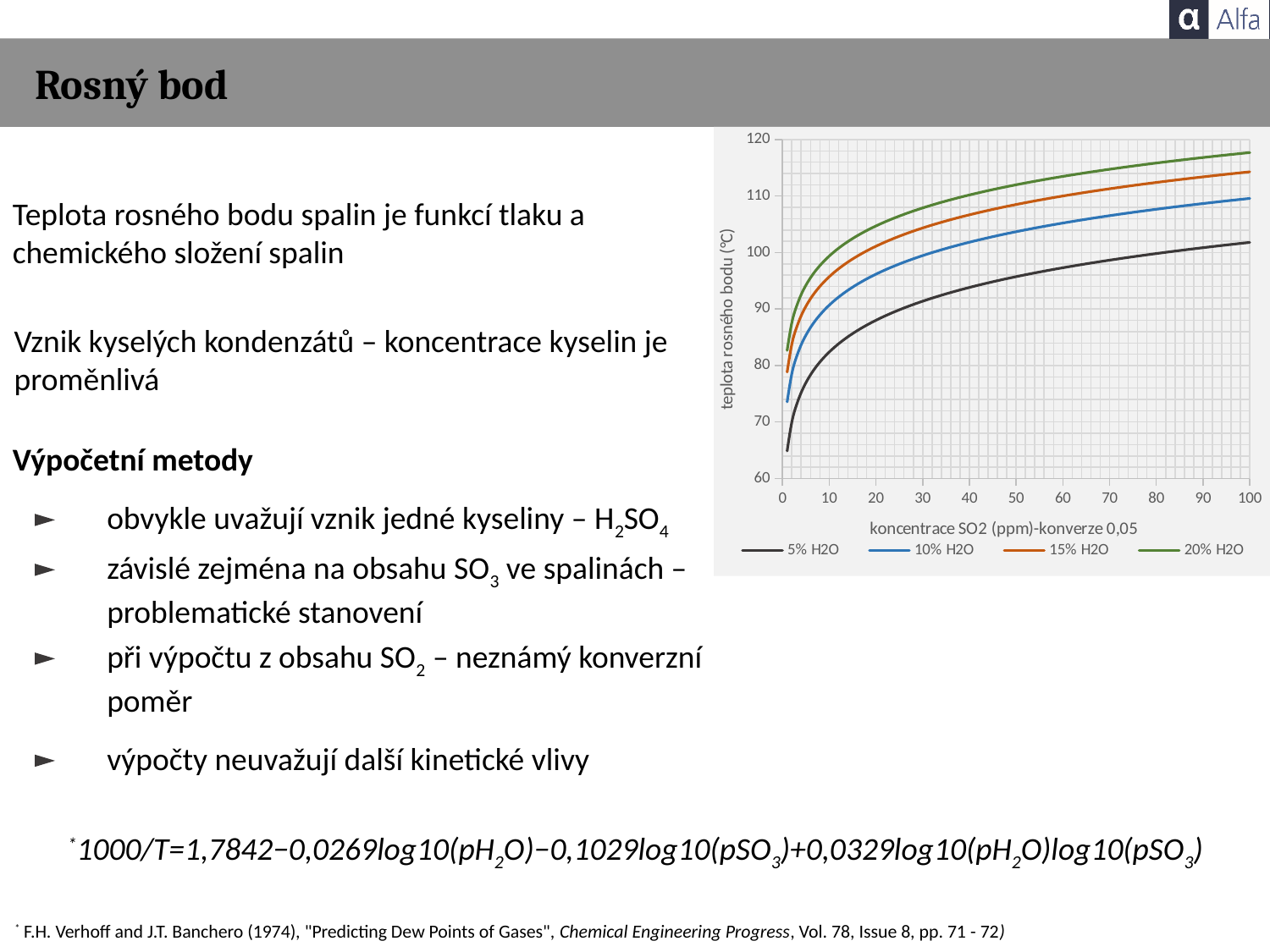
Is the dew point temperature for 5% H2O at 10 ppm SO2 greater or less than 80? greater Is the dew point temperature for 20% H2O at 100 ppm SO2 greater or less than 110? greater Do the dew point temperatures rise or fall as the SO2 concentration increases along the x axis? rise How many series does the chart legend list? 4 Which series has the lowest dew point temperature across the SO2 concentration range? 5% H2O What is the label of the chart's y axis? teplota rosného bodu (°C) What is the label of the chart's x axis? koncentrace SO2 (ppm)-konverze 0,05 Is the dew point temperature for 15% H2O at 100 ppm SO2 greater or less than 110? greater At 50 ppm SO2, which series has the higher dew point temperature, 20% H2O or 5% H2O? 20% H2O What kind of chart is shown on the slide? line chart Which series has the highest dew point temperature across the SO2 concentration range? 20% H2O